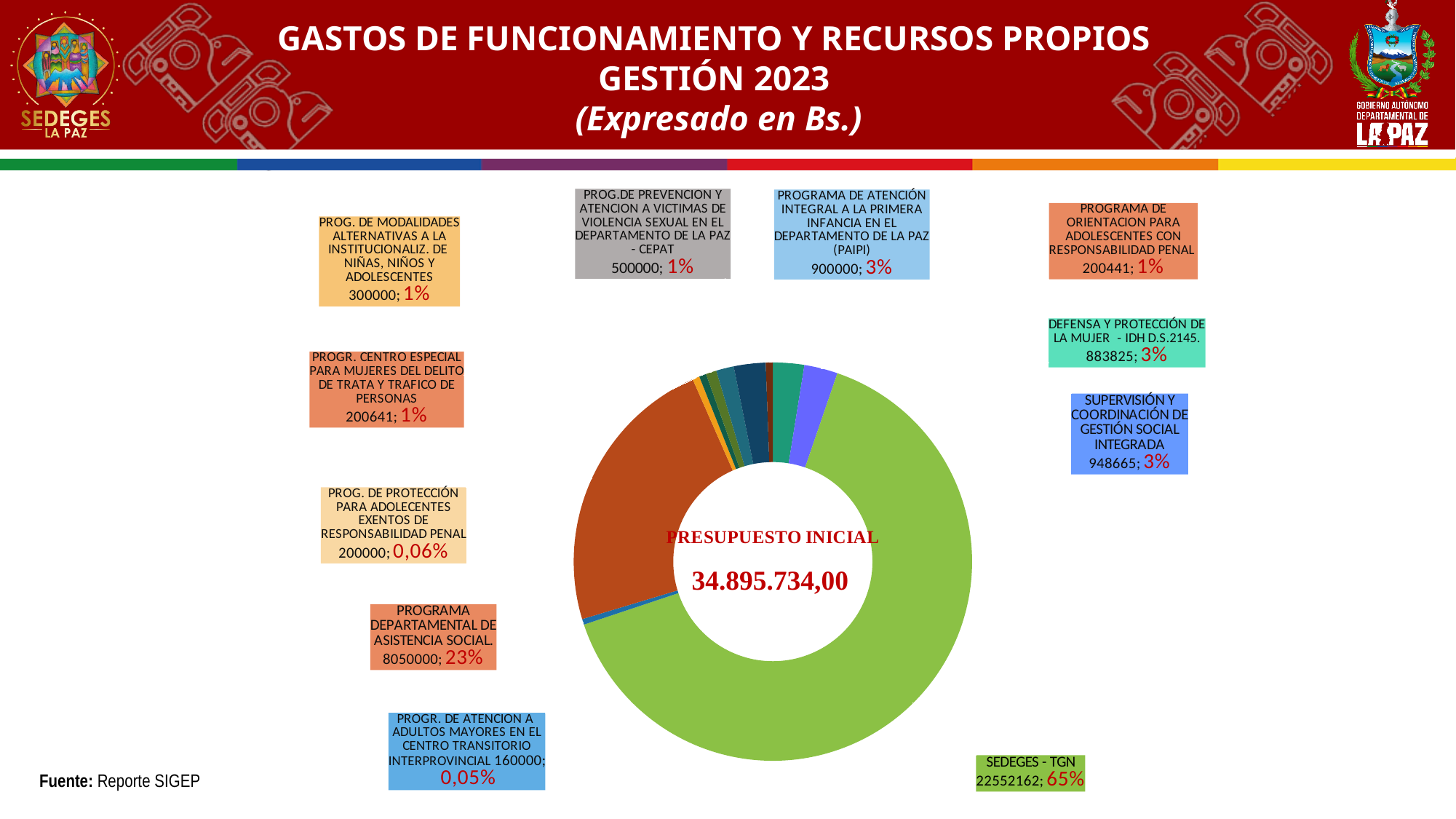
Which is larger: the value for PAIPI or the value for CEPAT? PAIPI Which category has the largest share of the chart? SEDEGES - TGN What kind of chart is shown on the slide? Pie chart (doughnut) What share of the chart does PROGRAMA DEPARTAMENTAL DE ASISTENCIA SOCIAL represent? 23% What share of the chart does SEDEGES - TGN represent? 65% What is the value for DEFENSA Y PROTECCIÓN DE LA MUJER - IDH D.S.2145? 883825 What is the value for PROGRAMA DE ATENCIÓN INTEGRAL A LA PRIMERA INFANCIA EN EL DEPARTAMENTO DE LA PAZ (PAIPI)? 900000 How many categories are shown in the chart? 11 What is the value for PROGRAMA DEPARTAMENTAL DE ASISTENCIA SOCIAL? 8050000 What is the value for SEDEGES - TGN? 22552162 What is the difference between the values for SEDEGES - TGN and PROGRAMA DEPARTAMENTAL DE ASISTENCIA SOCIAL? 14502162 Which category has the smallest value? PROGR. DE ATENCION A ADULTOS MAYORES EN EL CENTRO TRANSITORIO INTERPROVINCIAL